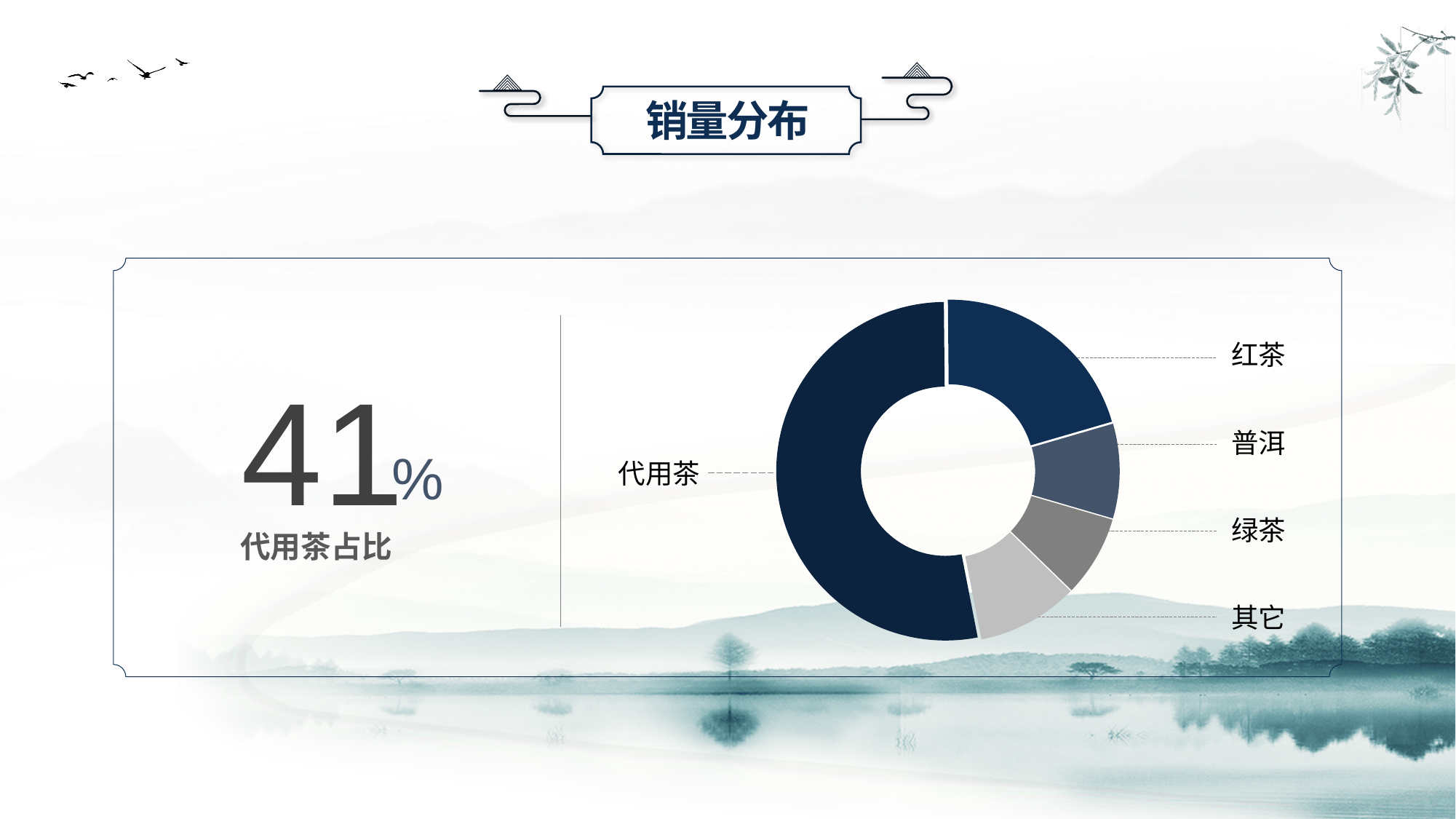
What kind of chart is shown on the slide? Pie chart (donut) Which slice is larger, 红茶 or 绿茶? 红茶 Which slice is larger, 代用茶 or 红茶? 代用茶 Which category is labelled on the left side of the donut chart? 代用茶 How many categories does the donut chart show? 5 Which slice is larger, 红茶 or 普洱? 红茶 What share of the total does 代用茶 account for? 41% Which category has the largest slice in the donut chart? 代用茶 What is the title of the slide containing the chart? 销量分布 What percentage is shown on the slide for 代用茶占比? 41%